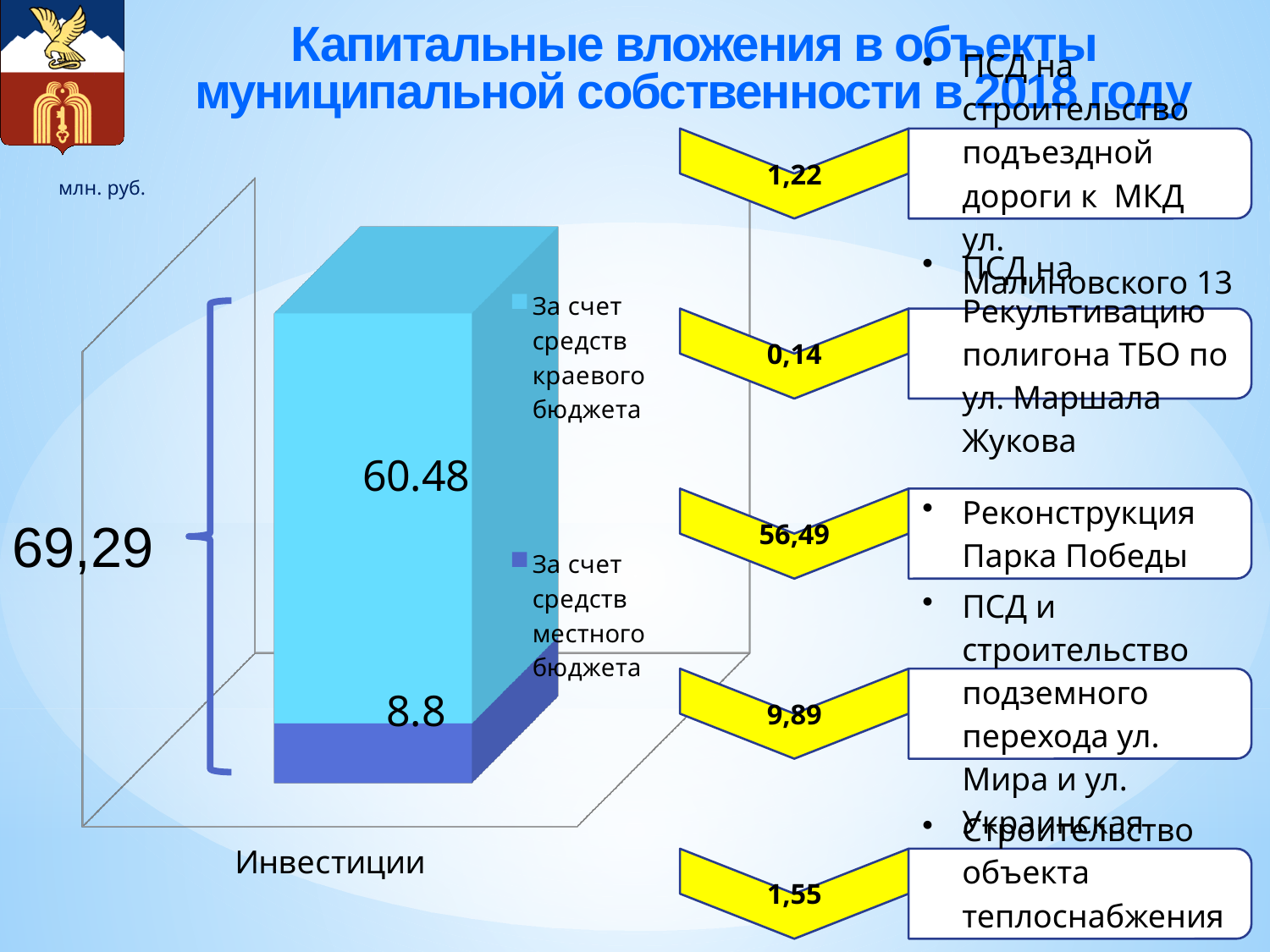
How many series does the chart legend list? 2 What is the category label on the x axis of the chart? Инвестиции How many categories are plotted on the x axis of the chart? 1 What is the total of the stacked bar for "Инвестиции" as shown on the slide? 69,29 What unit of measurement is indicated for the chart values? млн. руб. What is the value for "За счет средств местного бюджета" in the chart? 8.8 What kind of chart is shown on the slide? bar chart Which series has the smallest value in the chart? За счет средств местного бюджета What is the value for "За счет средств краевого бюджета" in the chart? 60.48 Which series has the larger value in the chart, "За счет средств краевого бюджета" or "За счет средств местного бюджета"? За счет средств краевого бюджета What is the difference between the values for "За счет средств краевого бюджета" and "За счет средств местного бюджета"? 51.68